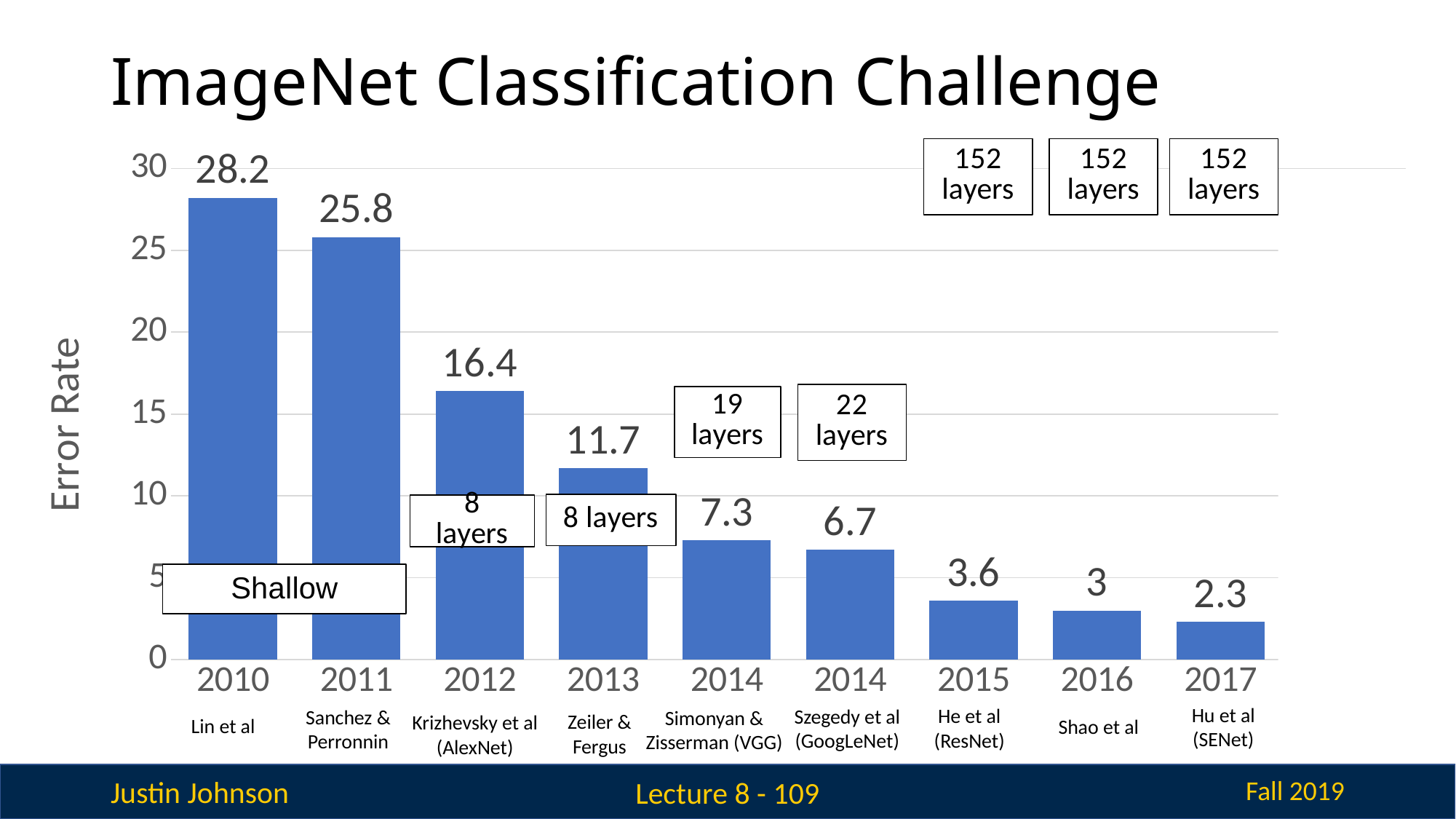
Which year has the highest error rate? 2010 What kind of chart is shown on the slide? Bar chart Do the error rates rise or fall from 2010 to 2017? Fall What is the error rate for 2017 (Hu et al, SENet)? 2.3 What is the error rate for 2015 (He et al, ResNet)? 3.6 How many bars are shown in the chart? 9 What is the label on the y axis of the chart? Error Rate Which year has the lowest error rate? 2017 Which has a higher error rate: Simonyan & Zisserman (VGG) or Szegedy et al (GoogLeNet)? Simonyan & Zisserman (VGG) What is the difference in error rate between 2010 (Lin et al) and 2011 (Sanchez & Perronnin)? 2.4 What is the difference in error rate between 2012 (AlexNet) and 2013 (Zeiler & Fergus)? 4.7 What is the error rate for 2012 (Krizhevsky et al, AlexNet)? 16.4